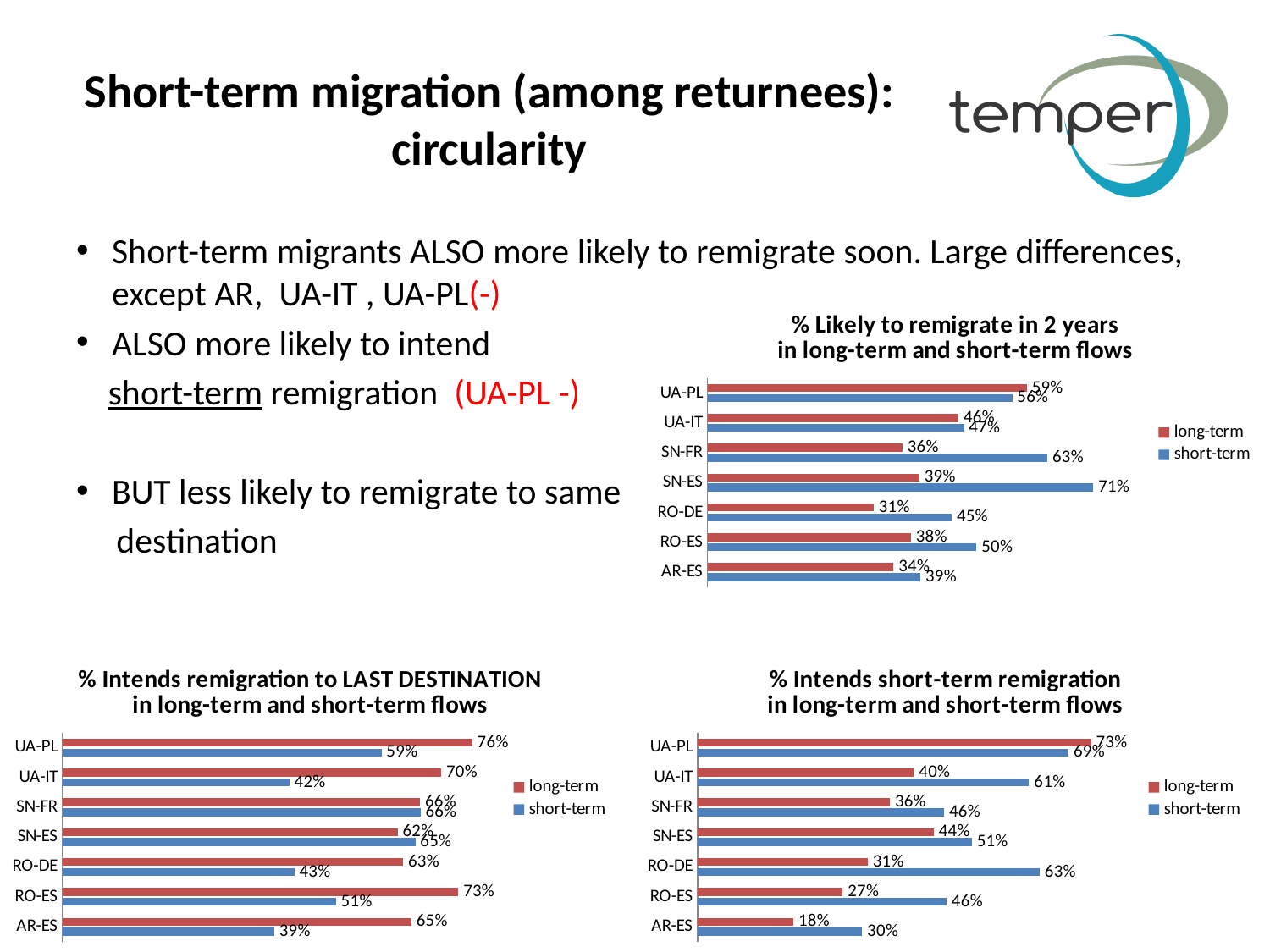
In the chart '% Intends short-term remigration', which category has the lowest long-term value? AR-ES How many series does the legend list in the chart '% Likely to remigrate in 2 years'? 2 In the chart '% Likely to remigrate in 2 years', which category has the highest short-term value? SN-ES How many categories are shown in the chart '% Intends short-term remigration'? 7 In the chart '% Likely to remigrate in 2 years', what is the long-term value for RO-DE? 31% In the chart '% Intends remigration to LAST DESTINATION', what is the long-term value for RO-ES? 73% In the chart '% Intends short-term remigration', what is the short-term value for RO-DE? 63% In the chart '% Intends remigration to LAST DESTINATION', which is larger for UA-IT: the long-term or the short-term value? long-term In the chart '% Likely to remigrate in 2 years', what is the difference between the short-term and long-term values for SN-FR? 27% In the chart '% Likely to remigrate in 2 years', what is the short-term value for SN-ES? 71% In the chart '% Intends remigration to LAST DESTINATION', which category has the lowest short-term value? AR-ES In the chart '% Intends short-term remigration', what is the difference between the short-term and long-term values for RO-DE? 32%